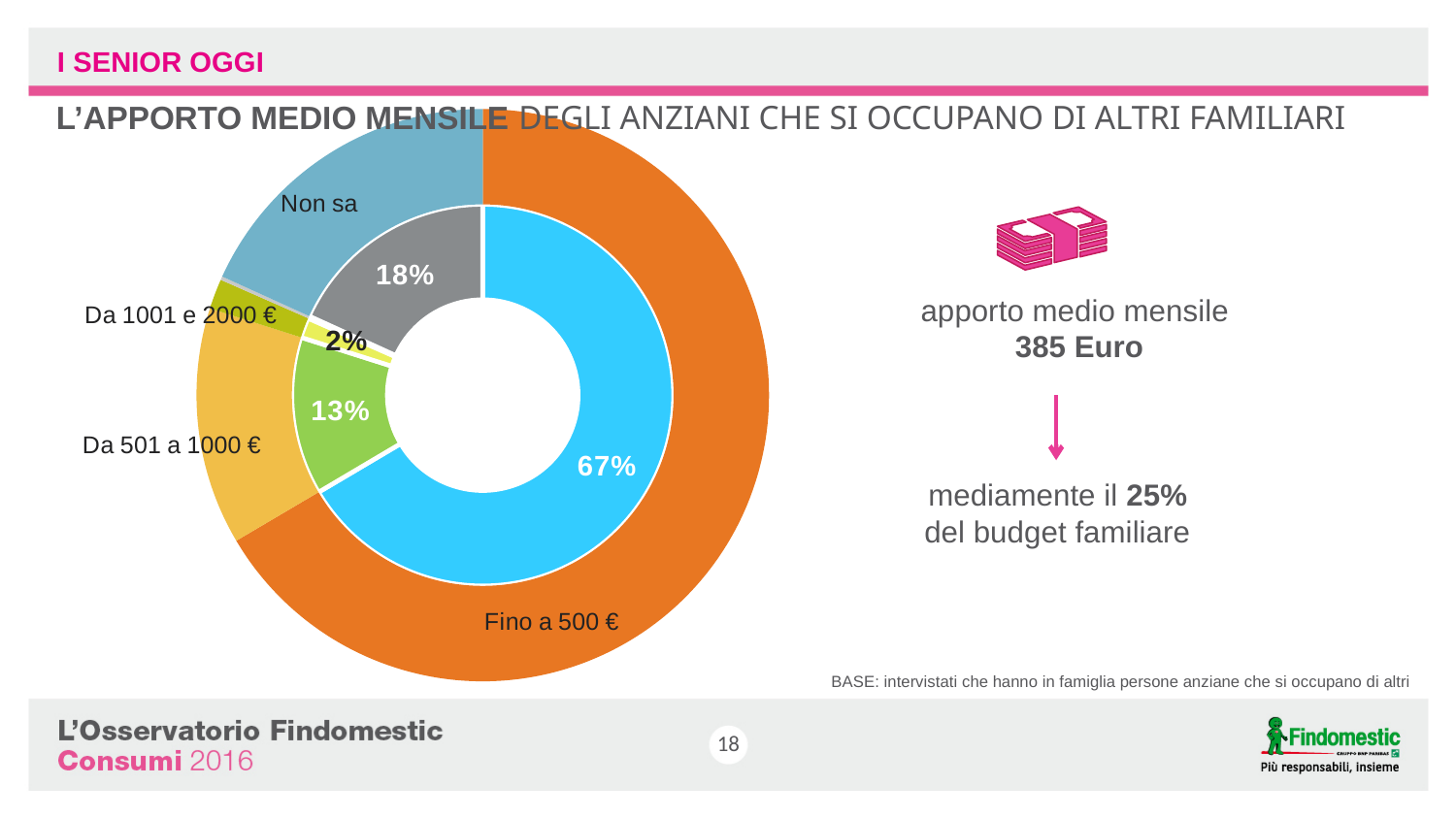
What is the value for "Da 501 a 1000 €"? 13% What is the combined share of "Da 501 a 1000 €" and "Da 1001 e 2000 €"? 15% Which is larger, the share for "Non sa" or the share for "Da 501 a 1000 €"? Non sa What kind of chart is shown on the slide? Doughnut chart What is the value for "Fino a 500 €"? 67% What is the value for "Non sa"? 18% Which category has the smallest share? Da 1001 e 2000 € Which category has the largest share? Fino a 500 € How many categories does the chart show? 4 What is the value for "Da 1001 e 2000 €"? 2% What is the difference between the shares of "Fino a 500 €" and "Non sa"? 49 percentage points